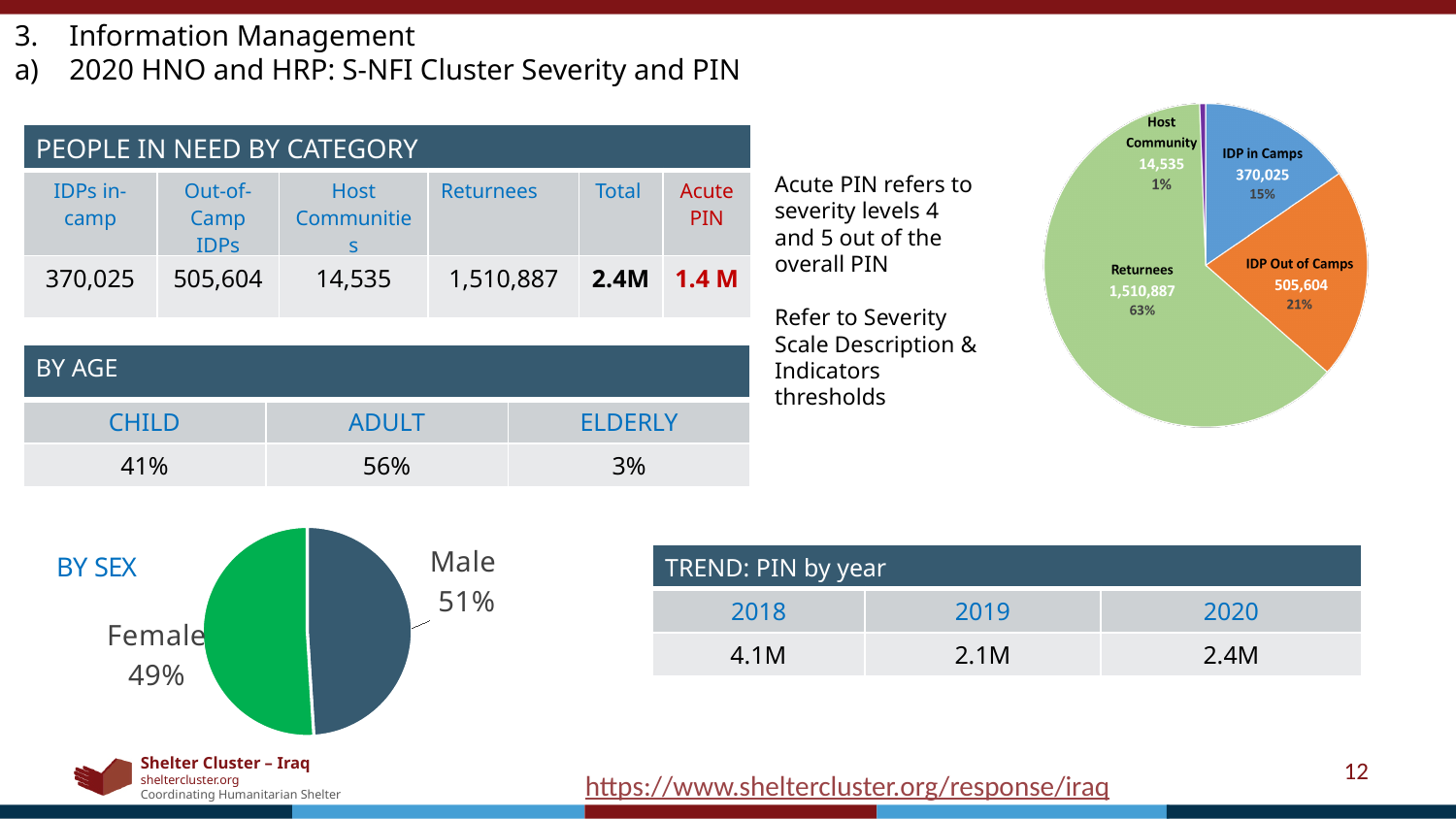
In the pie chart at the top right, which is larger: IDP in Camps or IDP Out of Camps? IDP Out of Camps What kind of chart is the chart at the top right of the slide? pie chart In the pie chart at the top right, what is the value for Returnees? 1,510,887 In the BY SEX pie chart at the bottom left, which slice is larger: Male or Female? Male In the pie chart at the top right, which category has the largest slice? Returnees How many slices does the BY SEX pie chart at the bottom left have? 2 In the BY SEX pie chart at the bottom left, what share is Male? 51% How many slices does the pie chart at the top right have? 4 In the pie chart at the top right, what is the value for IDP Out of Camps? 505,604 In the pie chart at the top right, which category has the smallest slice? Host Community In the pie chart at the top right, what share of the pie do Returnees represent? 63% In the pie chart at the top right, what is the difference between the values for IDP Out of Camps and IDP in Camps? 135,579